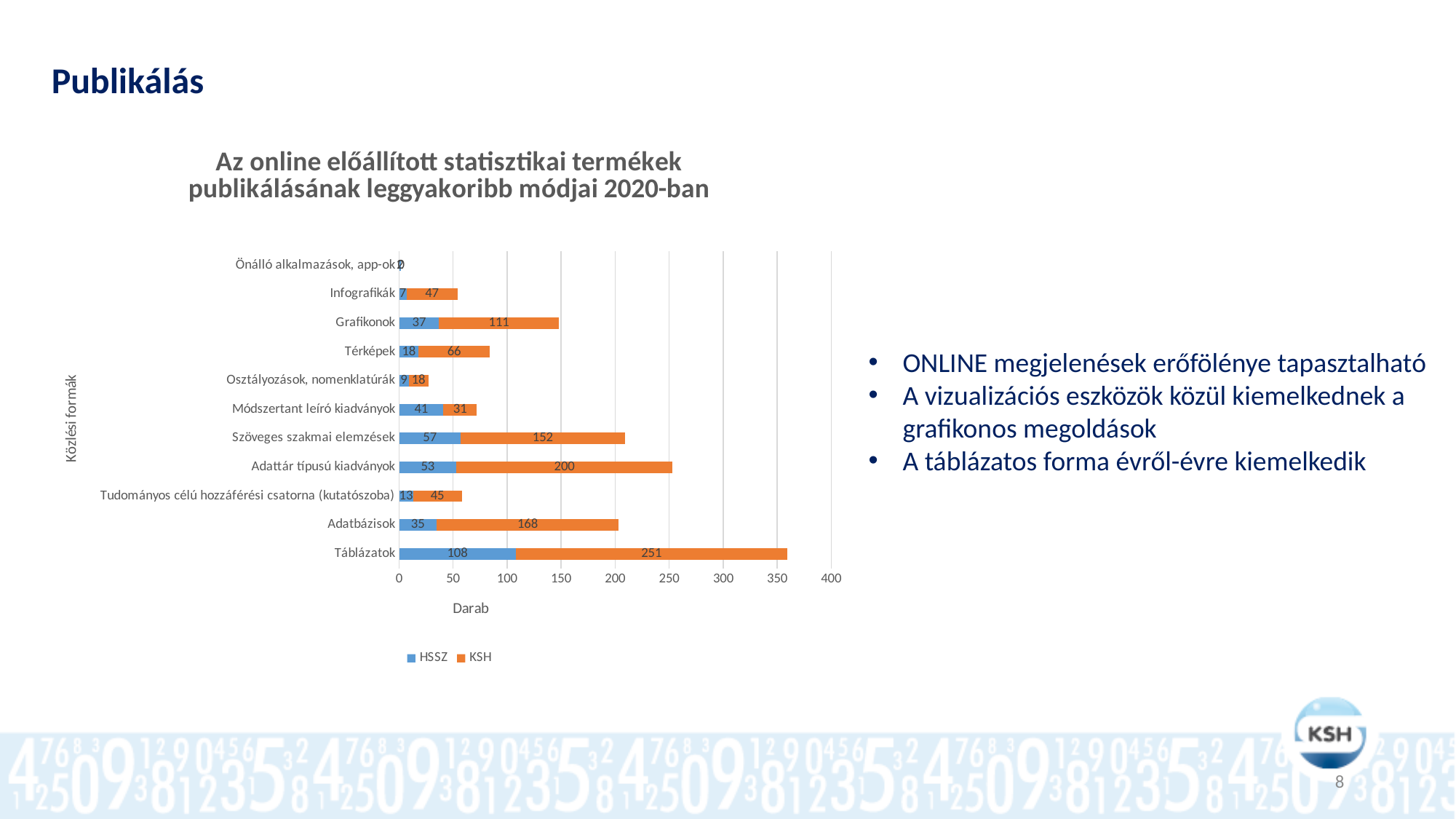
What is the difference between the KSH and HSSZ values for Szöveges szakmai elemzések? 95 What kind of chart is shown on the slide? stacked bar chart Which category has the highest KSH value? Táblázatok What is the label of the x axis? Darab What is the HSSZ value for Grafikonok? 37 What is the total of the stacked bar for Adatbázisok? 203 Which is larger for Módszertant leíró kiadványok, the HSSZ value or the KSH value? HSSZ Which category has the lowest HSSZ value? Önálló alkalmazások, app-ok How many series does the legend list? 2 What is the KSH value for Táblázatok? 251 How many categories (publication forms) are shown on the y axis? 11 What is the KSH value for Adattár típusú kiadványok? 200